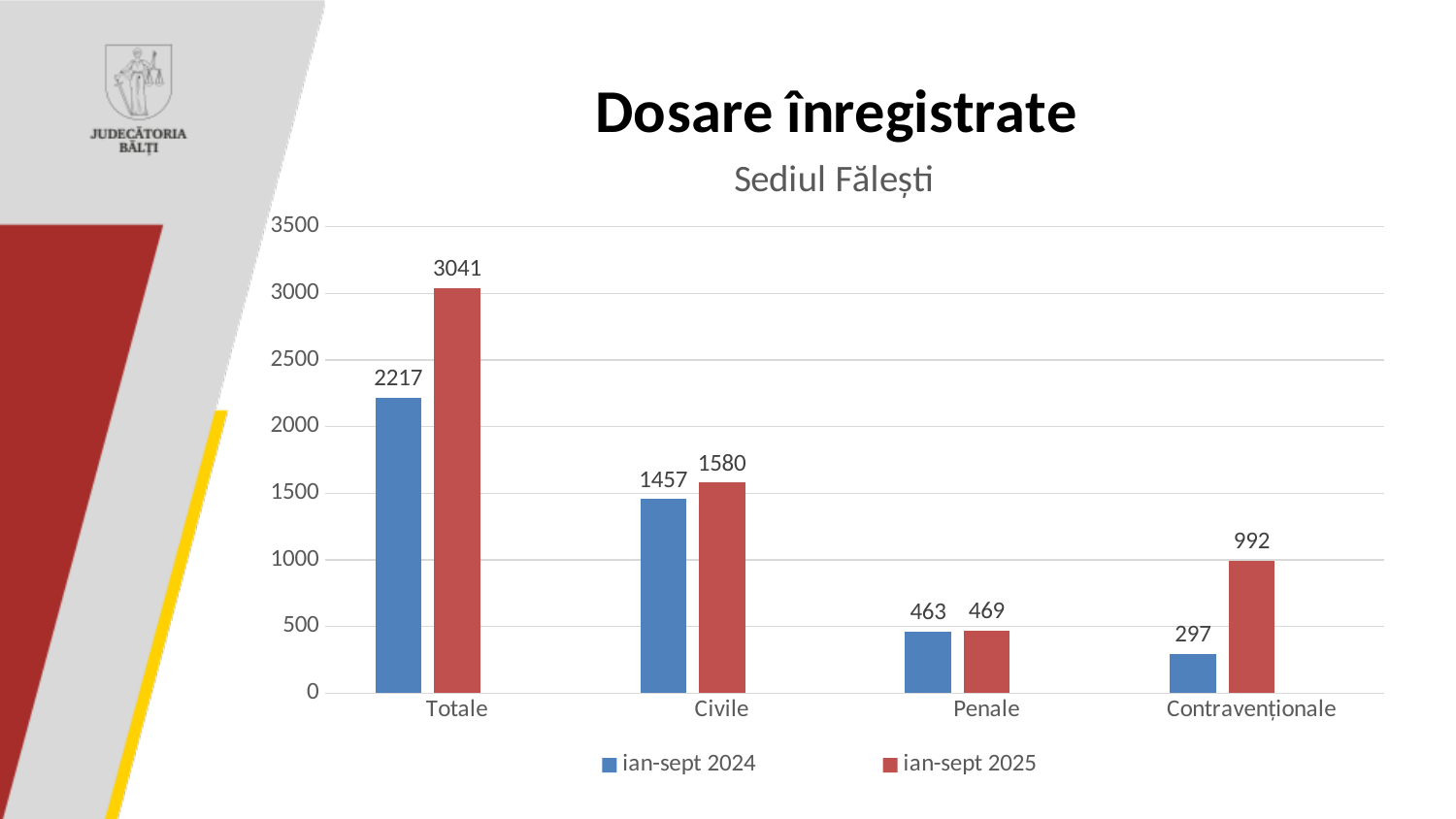
What is the value for Totale in the ian-sept 2025 series? 3041 What kind of chart is shown on the slide? bar chart What is the difference between the ian-sept 2025 and ian-sept 2024 values for Totale? 824 Which is larger for Civile: the ian-sept 2024 value or the ian-sept 2025 value? ian-sept 2025 What is the difference between the ian-sept 2025 and ian-sept 2024 values for Contravenționale? 695 Which category has the lowest value in the ian-sept 2025 series? Penale Is the value for Penale in the ian-sept 2024 series greater or less than 500? less Which category has the highest value in the ian-sept 2024 series? Totale What is the value for Civile in the ian-sept 2024 series? 1457 What is the value for Contravenționale in the ian-sept 2024 series? 297 How many categories are shown on the x axis? 4 How many series does the legend list? 2